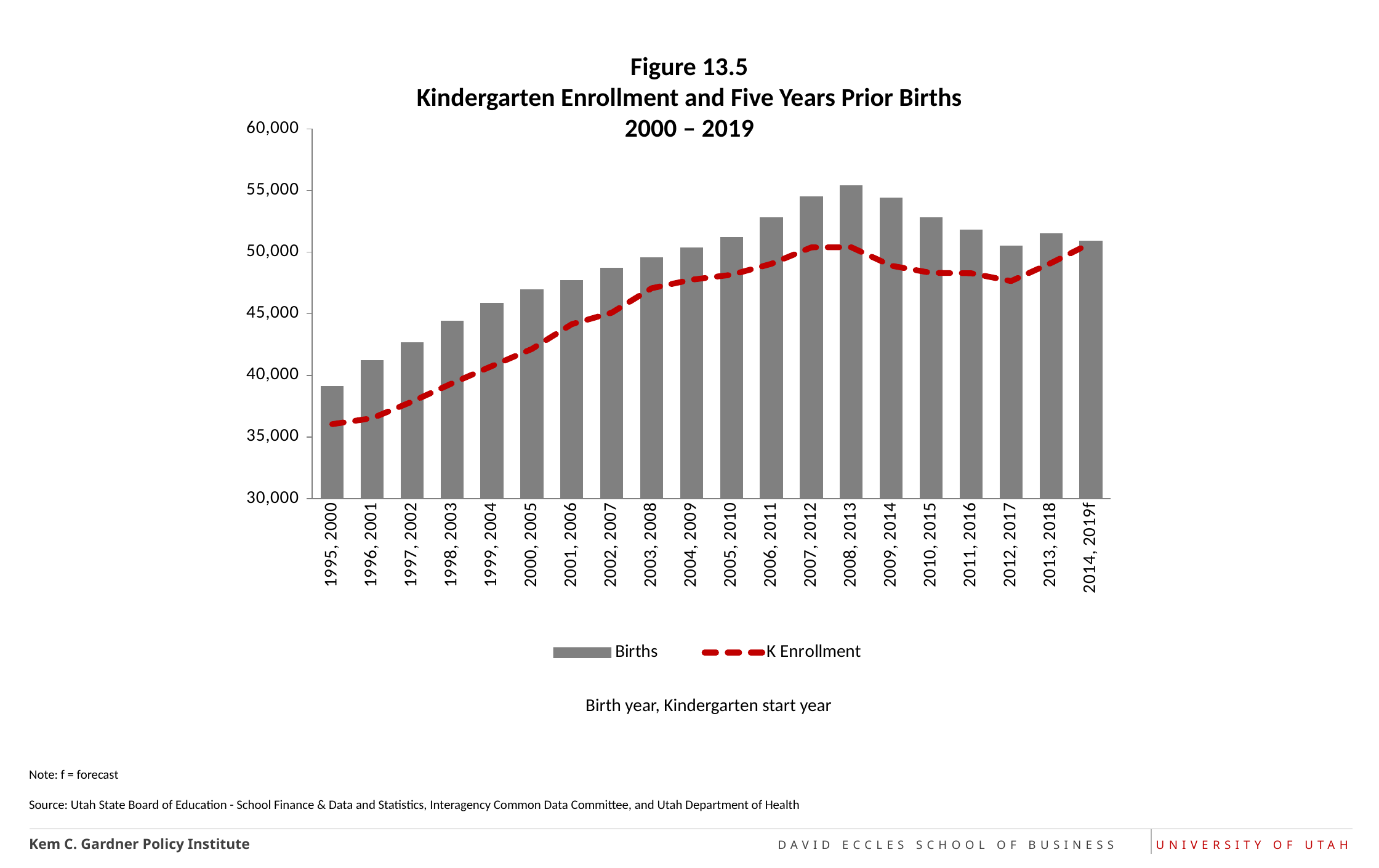
Is the K Enrollment value for 1995, 2000 greater or less than 35,000? greater Is the Births value for 1995, 2000 greater or less than 40,000? less Is the Births value for 2007, 2012 greater or less than 50,000? greater For 2008, 2013, which is larger: Births or K Enrollment? Births Which category has the highest Births bar? 2008, 2013 How many birth year / kindergarten start year categories are shown on the x axis? 20 What kind of chart is shown on the slide? A combined bar and line chart Which category has the lowest Births bar? 1995, 2000 Do the Births values rise or fall from 1995, 2000 to 2008, 2013? rise How many series does the legend list? 2